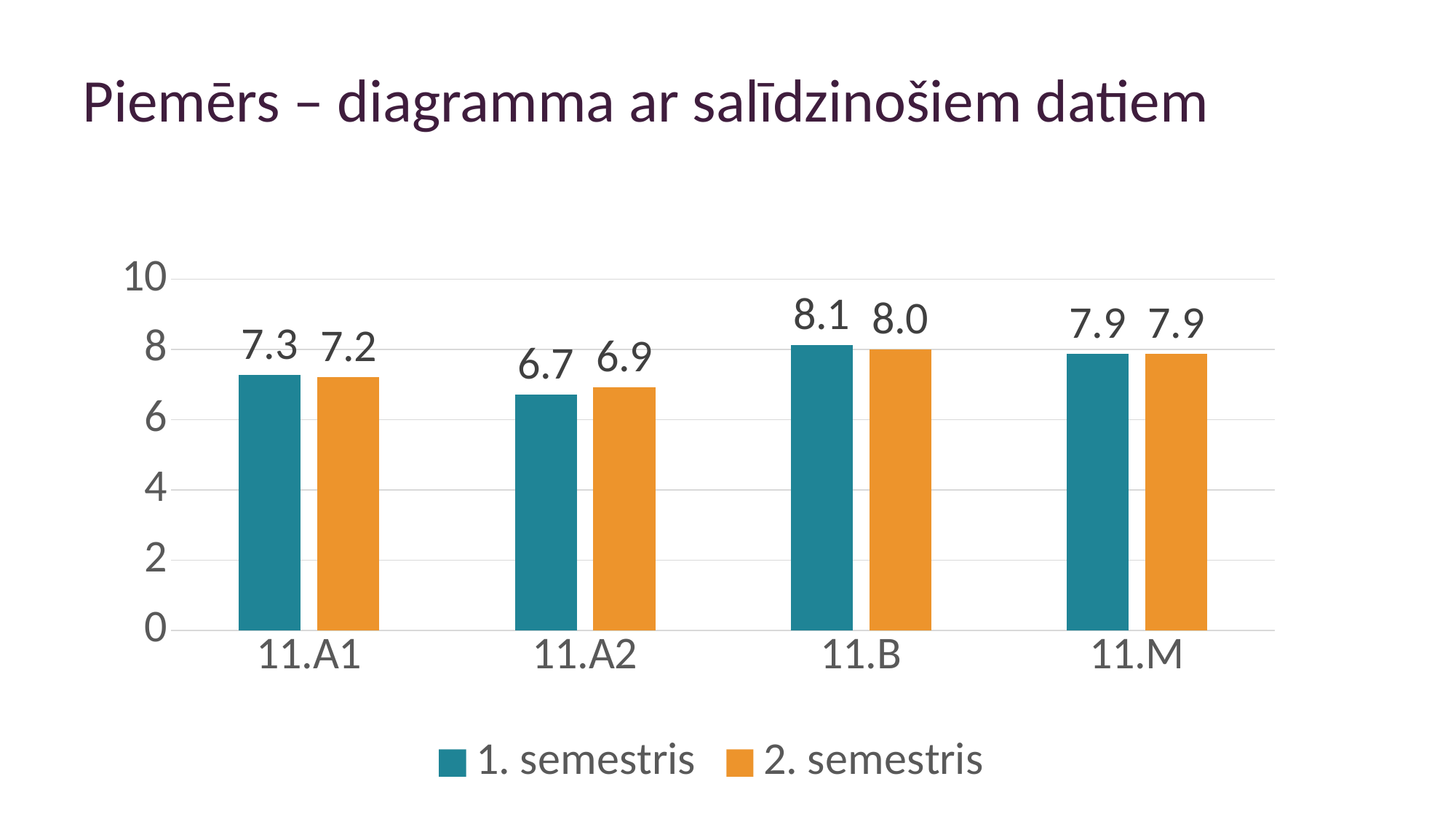
What is the difference between the 1. semestris and 2. semestris values for 11.A2? 0.2 What is the value for 11.M in the 2. semestris series? 7.9 What is the value for 11.B in the 1. semestris series? 8.1 What is the title of the slide? Piemērs – diagramma ar salīdzinošiem datiem How many categories are shown on the x axis? 4 What kind of chart is shown on the slide? Bar chart What is the value for 11.A1 in the 1. semestris series? 7.3 Which category has the highest value in the 1. semestris series? 11.B Which is larger for 11.A1: the 1. semestris value or the 2. semestris value? 1. semestris Which category has the lowest value in the 2. semestris series? 11.A2 What is the value for 11.A2 in the 2. semestris series? 6.9 How many series does the legend list? 2